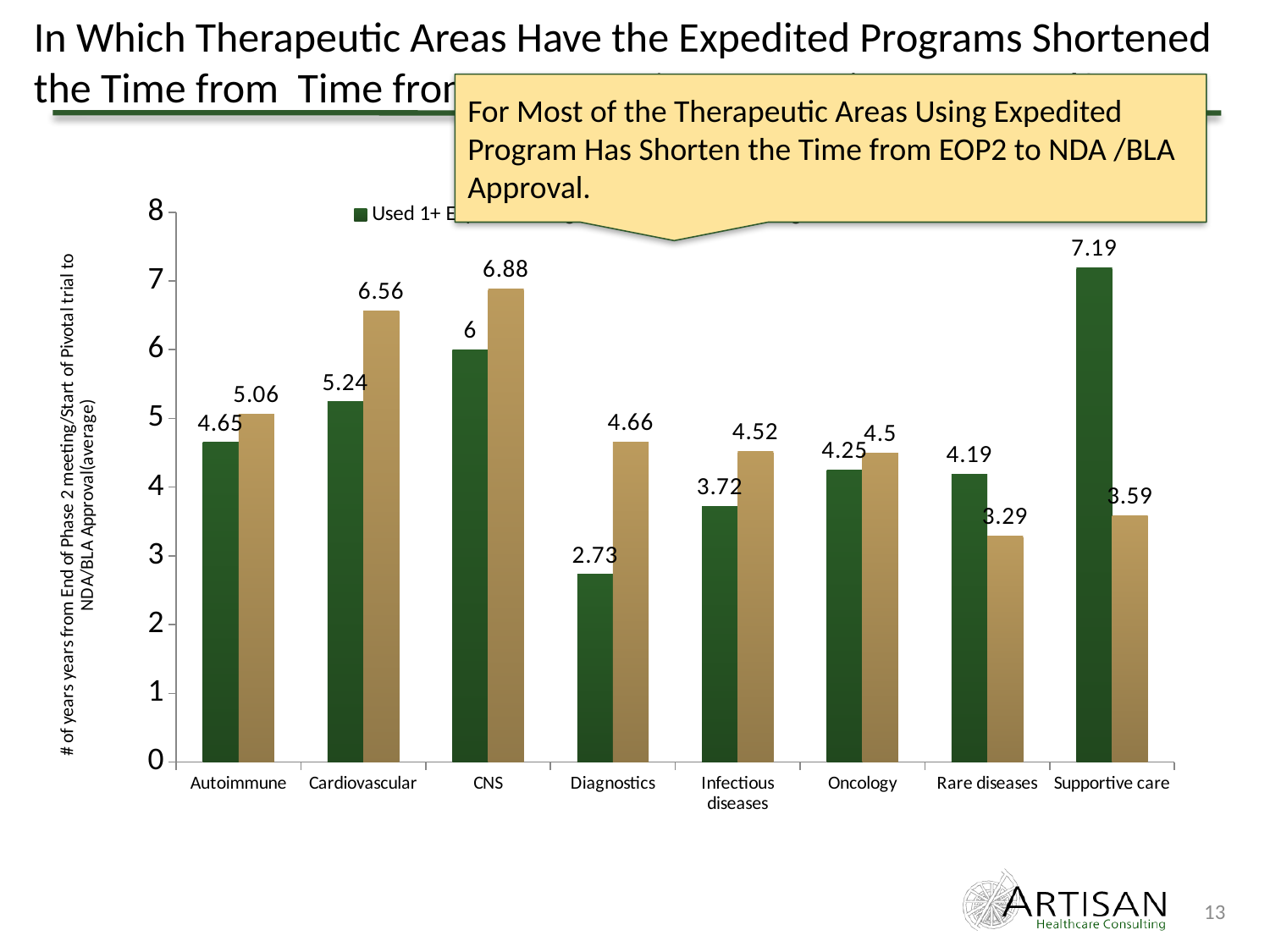
Which therapeutic area has the highest green bar? Supportive care For Cardiovascular, how much larger is the tan bar than the green bar? 1.32 For Oncology, which bar is larger, the green bar or the tan bar? The tan bar What is the value of the tan bar for CNS? 6.88 What kind of chart is shown on the slide? Bar chart Which therapeutic area has the lowest green bar? Diagnostics Which therapeutic area has the lowest tan bar? Rare diseases Which therapeutic area has the highest tan bar? CNS What is the value of the green bar for Diagnostics? 2.73 How many therapeutic areas are shown on the x axis? 8 How many bars are plotted for each therapeutic area? 2 For Supportive care, how much larger is the green bar than the tan bar? 3.6